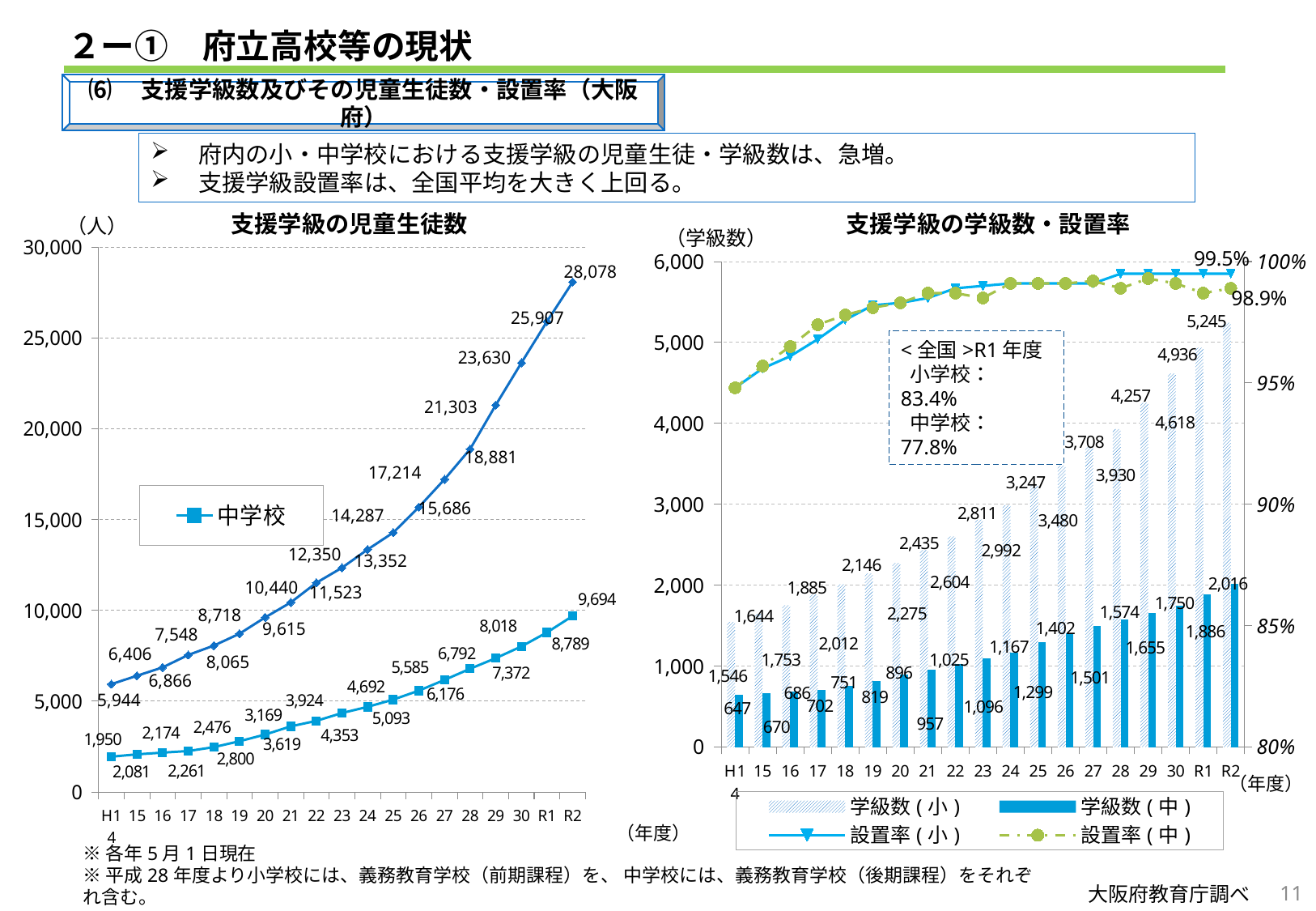
In the right chart (支援学級の学級数・設置率), what is the 設置率(小) value in R2? 99.5% In the right chart (支援学級の学級数・設置率), what is the value of 学級数(小) in R2? 5,245 In the right chart (支援学級の学級数・設置率), how many years are shown on the x axis? 19 In the left chart (支援学級の児童生徒数), what is the largest value labelled on the chart? 28,078 In the left chart (支援学級の児童生徒数), do the 中学校 values rise or fall from H14 to R2? rise In the left chart (支援学級の児童生徒数), what is the value for 中学校 in R2? 9,694 In the right chart (支援学級の学級数・設置率), what is the 設置率(中) value in R2? 98.9% In the left chart (支援学級の児童生徒数), what is the value for 中学校 in H14? 1,950 What kind of chart is the left chart (支援学級の児童生徒数)? line chart In the right chart (支援学級の学級数・設置率), what is the value of 学級数(中) in R2? 2,016 In the right chart (支援学級の学級数・設置率), what is the difference between 学級数(小) and 学級数(中) in R2? 3,229 In the right chart (支援学級の学級数・設置率), how many series does the legend list? 4